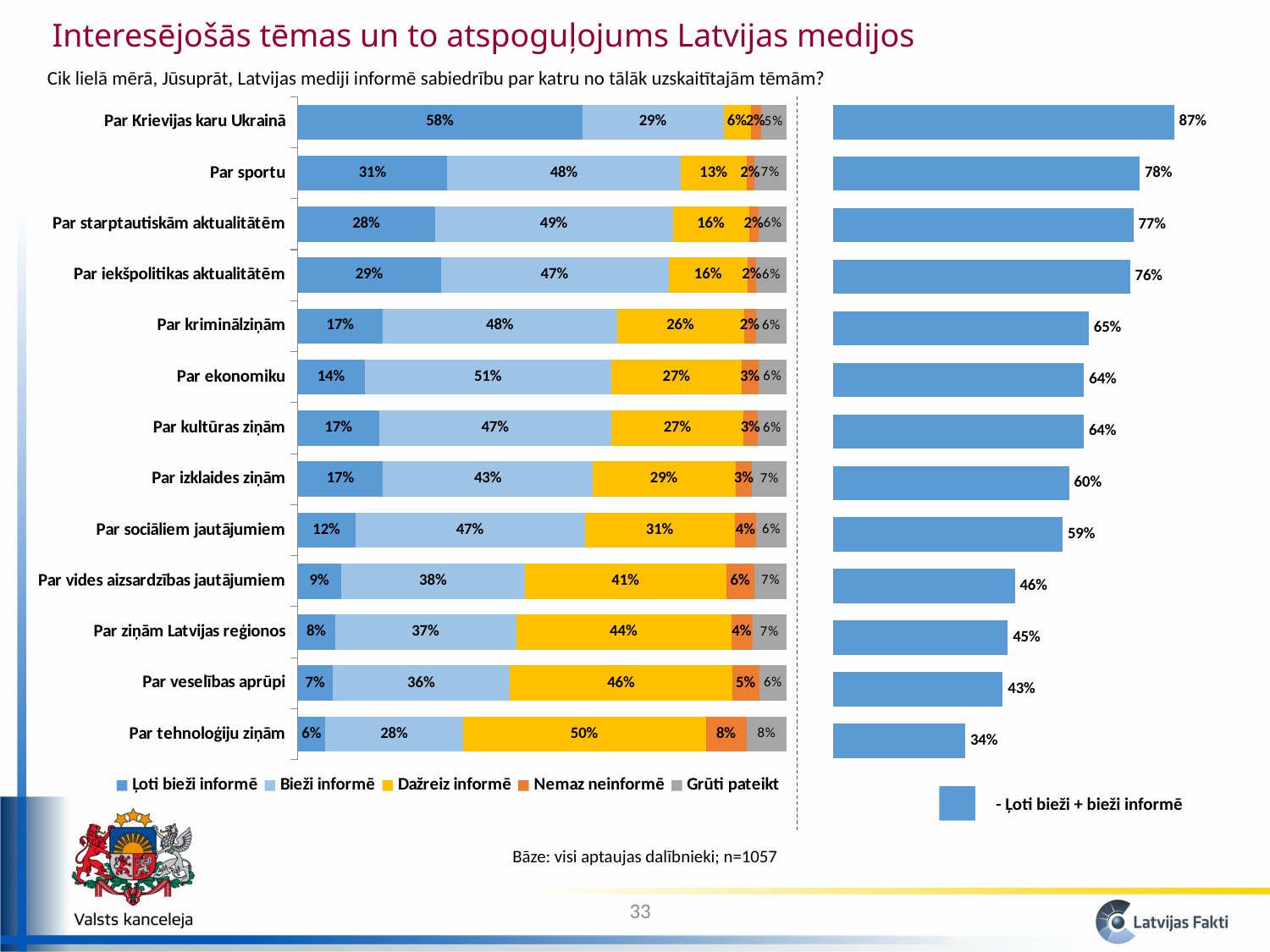
In the stacked bar chart on the left, what is the 'Ļoti bieži informē' value for 'Par Krievijas karu Ukrainā'? 58% What kind of chart is the chart on the right of the slide? Bar chart In the stacked bar chart on the left, what is the total of the 'Ļoti bieži informē' and 'Bieži informē' segments for 'Par sociāliem jautājumiem'? 59% In the stacked bar chart on the left, which is larger: the 'Bieži informē' value for 'Par ekonomiku' or for 'Par vides aizsardzības jautājumiem'? Par ekonomiku How many categories are shown in the stacked bar chart on the left? 13 In the stacked bar chart on the left, what is the 'Dažreiz informē' value for 'Par tehnoloģiju ziņām'? 50% In the bar chart on the right ('Ļoti bieži + bieži informē'), what is the value for 'Par veselības aprūpi'? 43% How many series does the legend of the stacked bar chart on the left list? 5 In the bar chart on the right ('Ļoti bieži + bieži informē'), which category has the highest value? Par Krievijas karu Ukrainā In the bar chart on the right ('Ļoti bieži + bieži informē'), what is the difference between the values for 'Par sportu' and 'Par ekonomiku'? 14% In the bar chart on the right ('Ļoti bieži + bieži informē'), which category has the lowest value? Par tehnoloģiju ziņām What does the legend of the bar chart on the right say the bars represent? Ļoti bieži + bieži informē